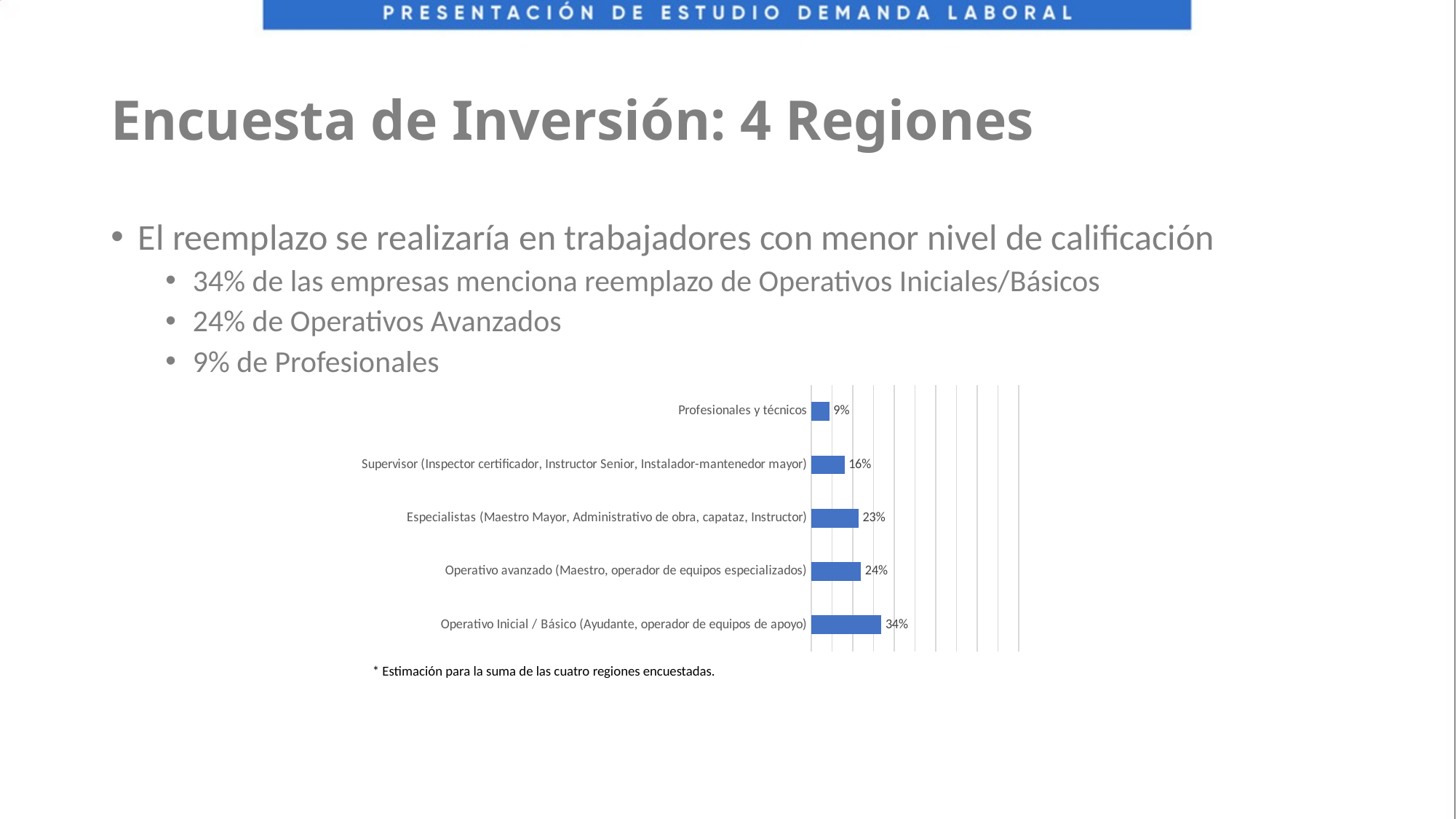
What is the value for Profesionales y técnicos? 9% What is the difference between the values for Operativo Inicial / Básico and Operativo avanzado? 10% What kind of chart is shown on the slide? Bar chart Which is larger, the value for Especialistas or the value for Supervisor? Especialistas What is the difference between the values for Supervisor and Profesionales y técnicos? 7% What is the value for Supervisor (Inspector certificador, Instructor Senior, Instalador-mantenedor mayor)? 16% How many categories are shown in the chart? 5 What is the value for Especialistas (Maestro Mayor, Administrativo de obra, capataz, Instructor)? 23% What does the footnote below the chart say? * Estimación para la suma de las cuatro regiones encuestadas. Which category has the highest value? Operativo Inicial / Básico (Ayudante, operador de equipos de apoyo) What is the value for Operativo Inicial / Básico (Ayudante, operador de equipos de apoyo)? 34% Which category has the lowest value? Profesionales y técnicos